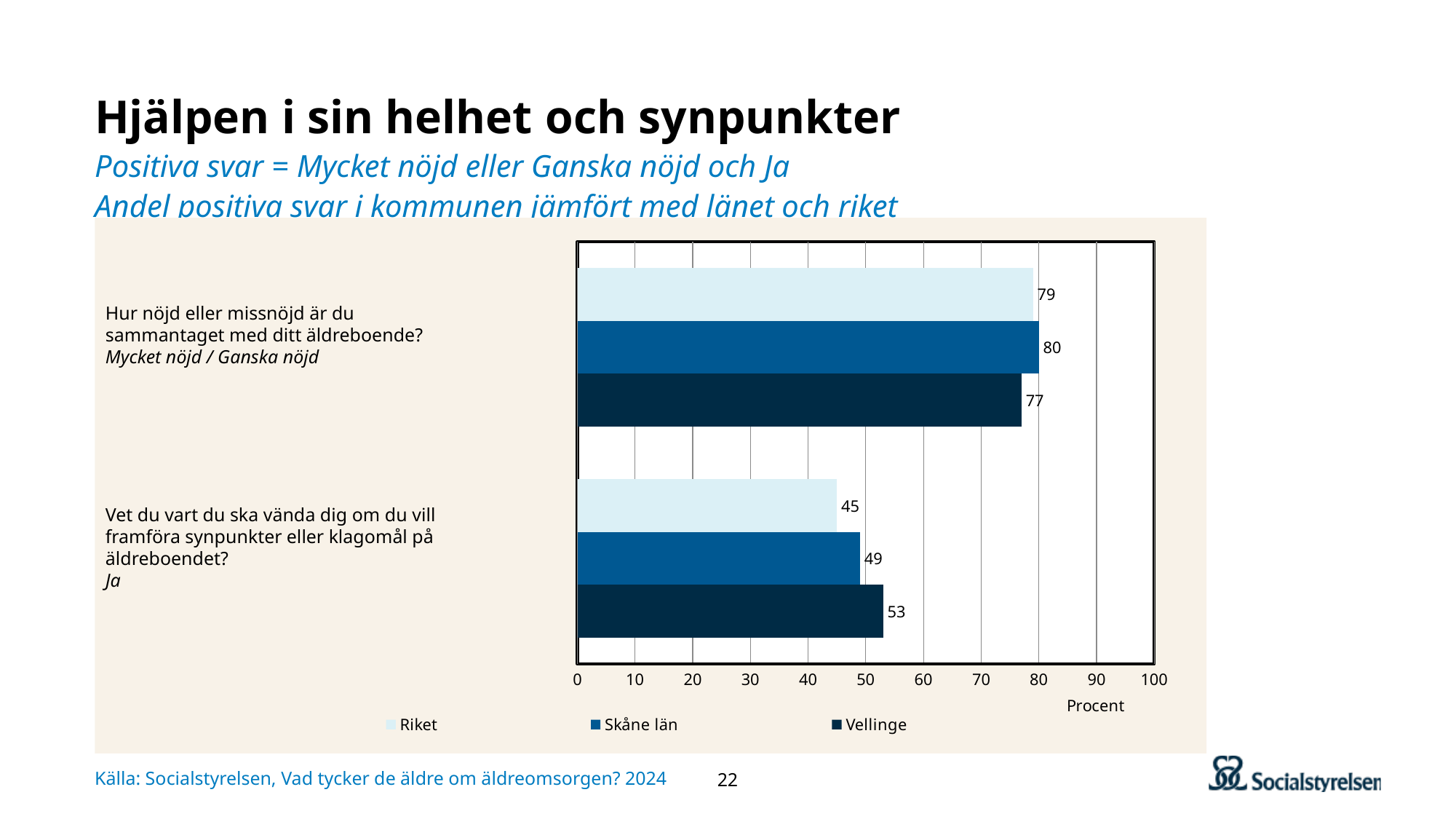
How many series does the legend list? 3 What is the difference between the Skåne län and Vellinge values on the question "Hur nöjd eller missnöjd är du sammantaget med ditt äldreboende?"? 3 Which is larger: the Riket value or the Vellinge value on the question "Vet du vart du ska vända dig om du vill framföra synpunkter eller klagomål på äldreboendet?"? Vellinge Which series has the lowest value on the question "Hur nöjd eller missnöjd är du sammantaget med ditt äldreboende?"? Vellinge What kind of chart is shown on the slide? Bar chart What is the difference between the Vellinge and Riket values on the question "Vet du vart du ska vända dig om du vill framföra synpunkter eller klagomål på äldreboendet?"? 8 Is the value for Skåne län on the question "Vet du vart du ska vända dig om du vill framföra synpunkter eller klagomål på äldreboendet?" greater or less than 50? less What unit is shown on the x axis of the chart? Procent What is the value for Riket on the question "Vet du vart du ska vända dig om du vill framföra synpunkter eller klagomål på äldreboendet?"? 45 What is the value for Vellinge on the question "Hur nöjd eller missnöjd är du sammantaget med ditt äldreboende?"? 77 Which series has the highest value on the question "Vet du vart du ska vända dig om du vill framföra synpunkter eller klagomål på äldreboendet?"? Vellinge What is the value for Skåne län on the question "Vet du vart du ska vända dig om du vill framföra synpunkter eller klagomål på äldreboendet?"? 49